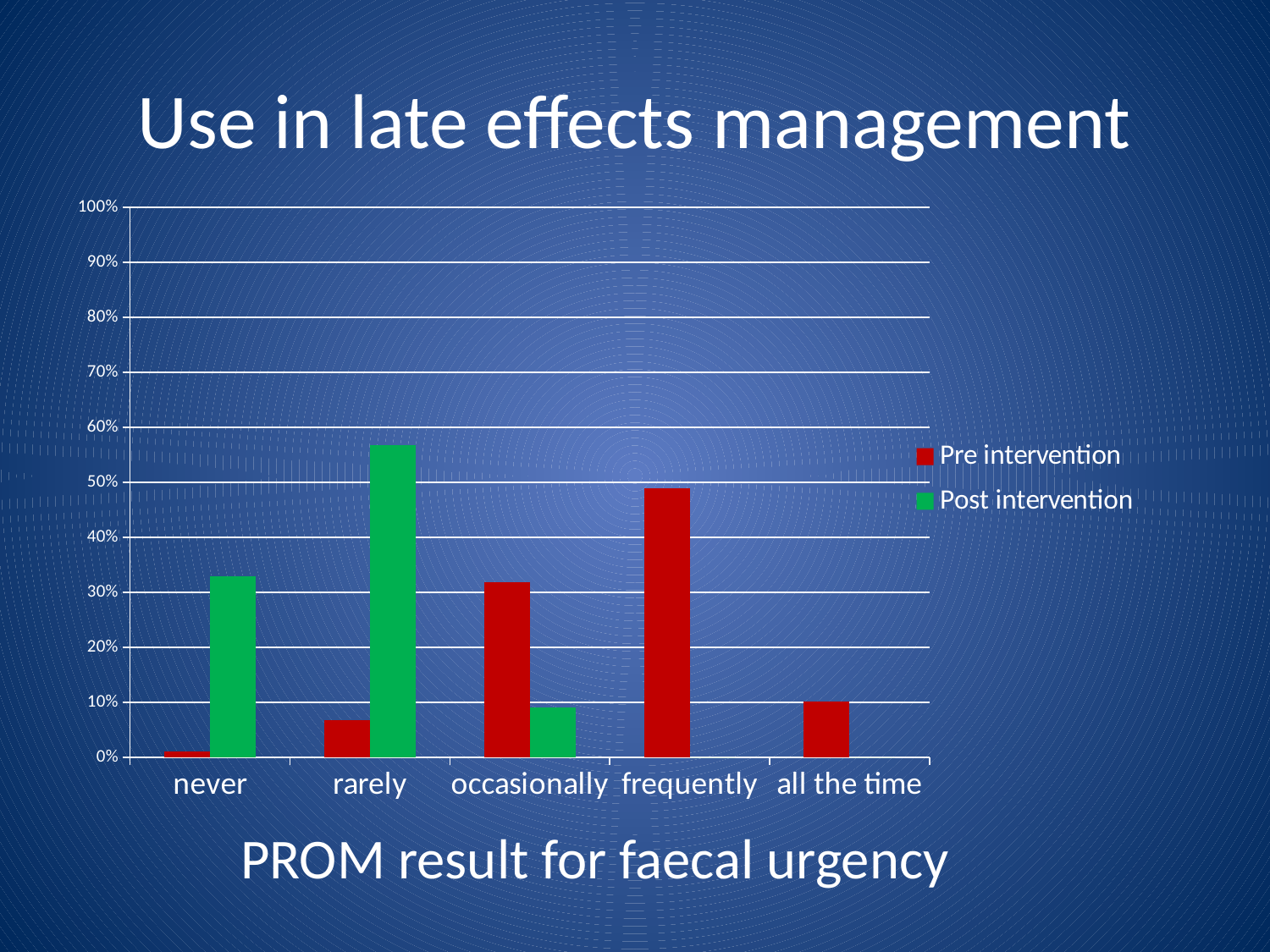
How many categories are shown on the x axis? 5 For the never category, which is larger: the Pre intervention value or the Post intervention value? Post intervention Which category has the lowest Pre intervention value? never How many series does the legend list? 2 What colour represents the Post intervention series? green Which category has the highest Post intervention value? rarely Is the Pre intervention value for rarely greater or less than 10%? less For the occasionally category, which is larger: the Pre intervention value or the Post intervention value? Pre intervention What kind of chart is shown on the slide? bar chart Is the Post intervention value for rarely greater or less than 50%? greater Is the Post intervention value for never greater or less than 20%? greater Which category has the highest Pre intervention value? frequently